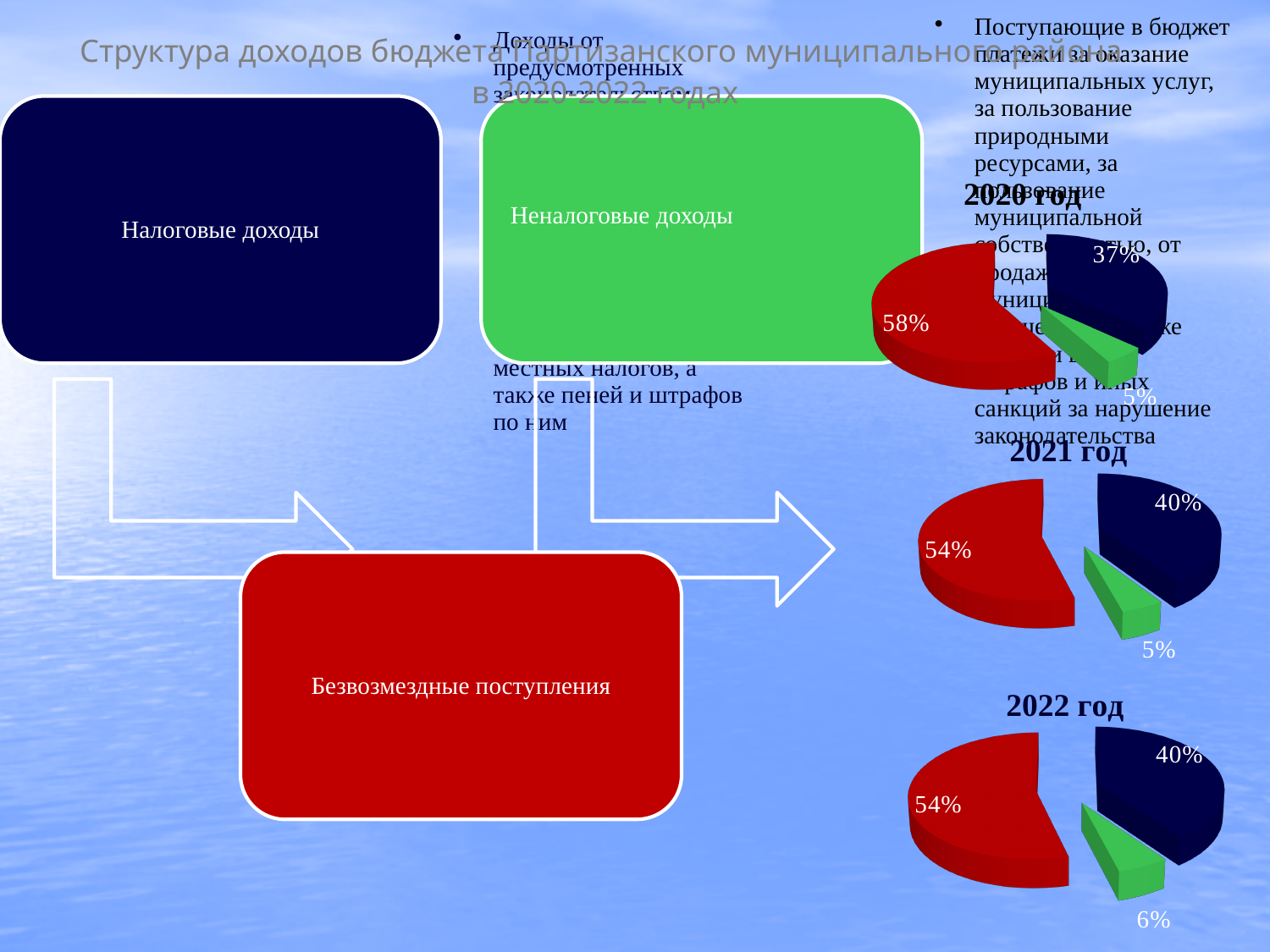
In the 2020 год pie chart, what is the difference between the red slice (58%) and the dark blue slice (37%)? 21% How many slices does the 2021 год pie chart have? 3 How many pie charts are shown on the slide? 3 In the 2022 год pie chart, which slice is larger, the red one or the dark blue one? the red one (54%) In the 2022 год pie chart, what is the value of the green slice? 6% In the 2022 год pie chart, what is the value of the dark blue slice? 40% In the 2020 год pie chart, what is the value of the smallest slice? 5% In the 2020 год pie chart, what is the value of the dark blue slice? 37% What kind of chart is used for the 2020 год chart? pie chart In the 2021 год pie chart, what is the value of the green slice? 5% In the 2021 год pie chart, what is the value of the red slice? 54% In the 2020 год pie chart, what is the value of the largest slice? 58%